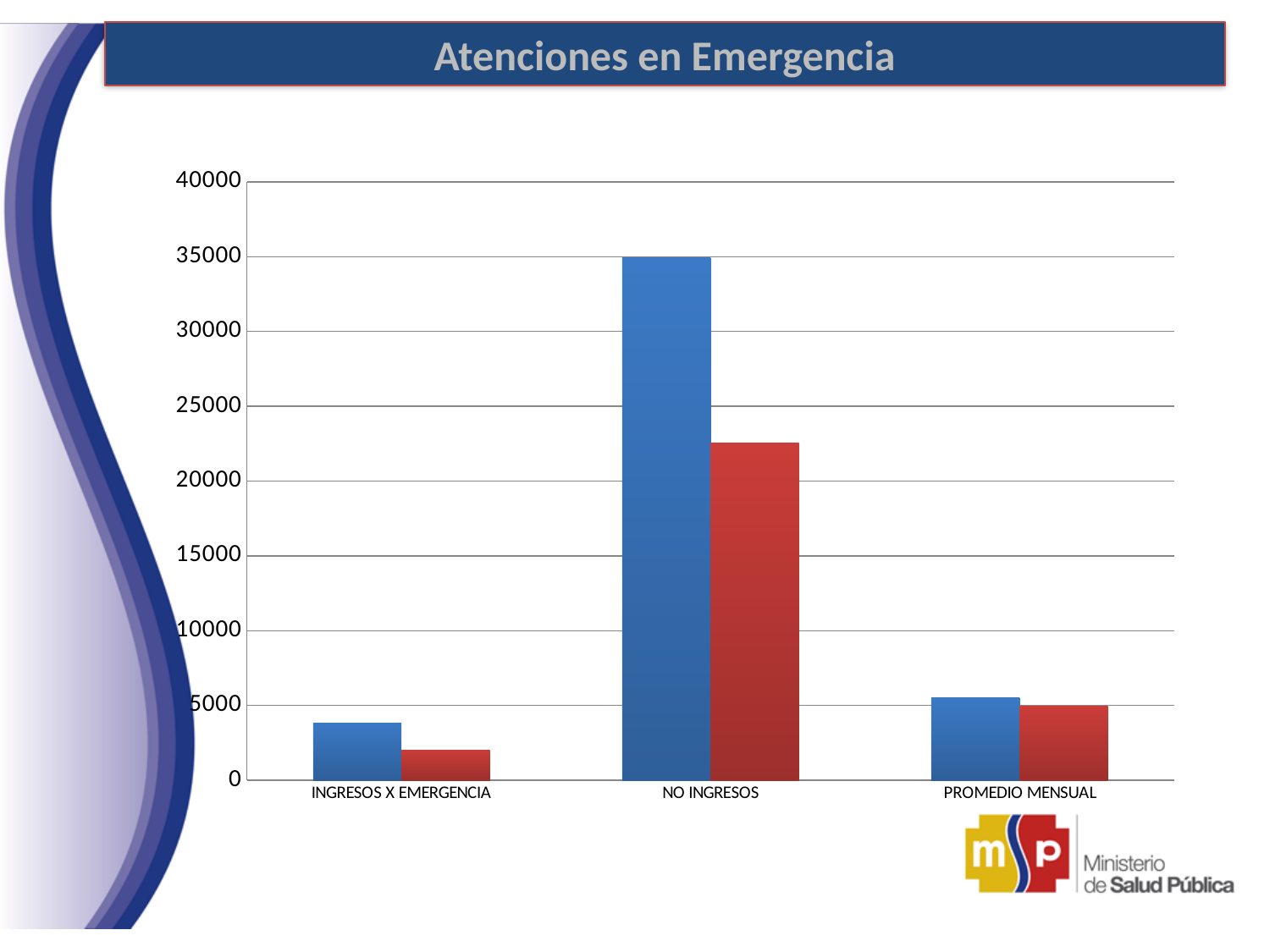
What kind of chart is shown on the slide? bar chart Is the red bar for NO INGRESOS greater or less than 25000? less Is the blue bar for PROMEDIO MENSUAL greater or less than 5000? greater How many categories are shown on the x axis of the chart? 3 How many bars are shown for each category? 2 Is the blue bar for INGRESOS X EMERGENCIA greater or less than 5000? less What is the title of the chart? Atenciones en Emergencia Which is larger, the red bar for PROMEDIO MENSUAL or the red bar for INGRESOS X EMERGENCIA? the red bar for PROMEDIO MENSUAL For NO INGRESOS, which bar is taller, the blue one or the red one? the blue one Which category has the shortest red bar? INGRESOS X EMERGENCIA Which category has the tallest blue bar? NO INGRESOS